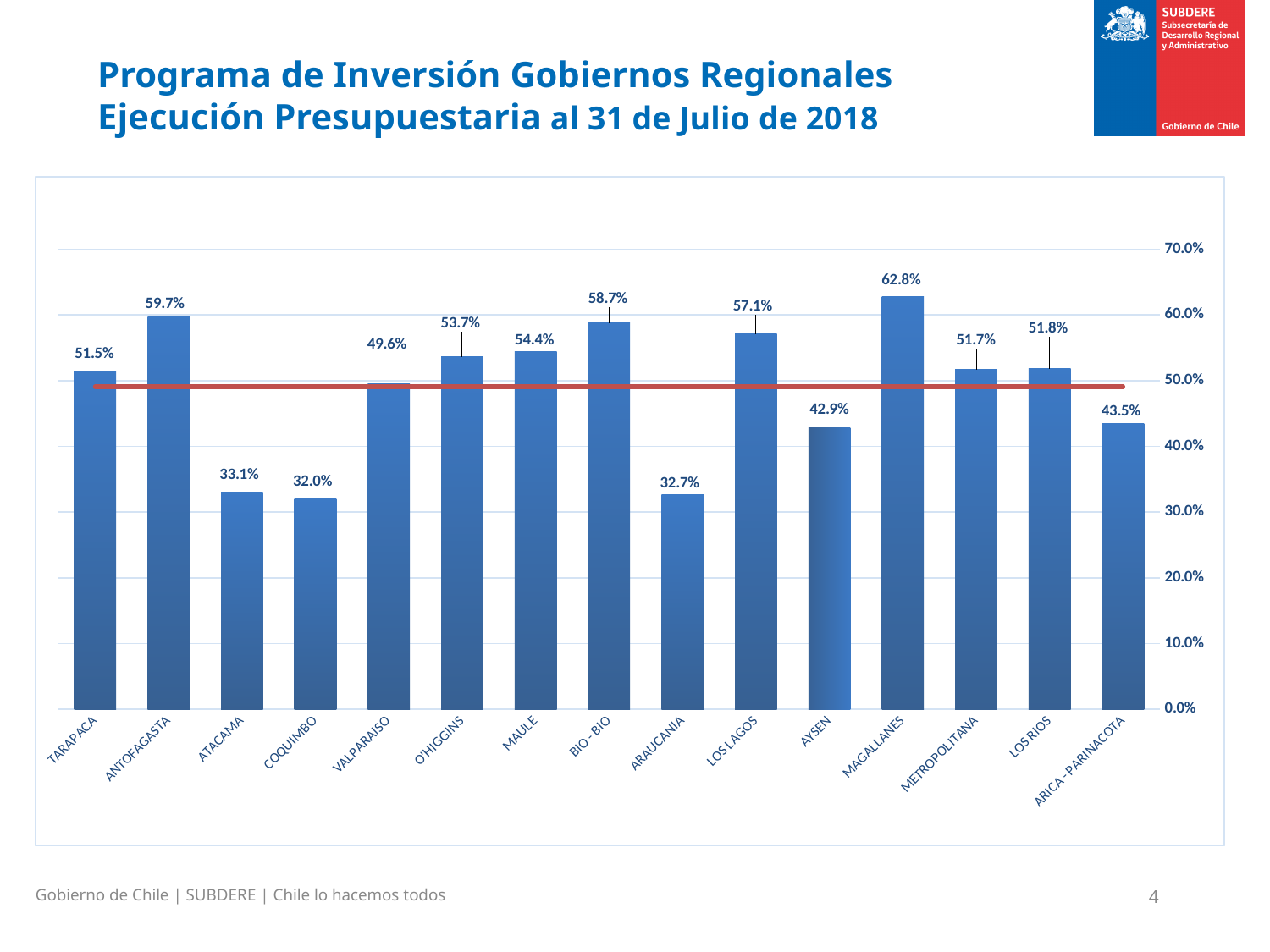
What is the value for MAGALLANES? 62.8% What is the value for ARAUCANIA? 32.7% Which region has the highest value? MAGALLANES Which is larger, the value for BIO - BIO or the value for LOS LAGOS? BIO - BIO What is the highest value shown on the y axis? 70.0% What is the difference between the values for MAGALLANES and ARICA - PARINACOTA? 19.3% What is the difference between the values for ANTOFAGASTA and ATACAMA? 26.6% What is the value for VALPARAISO? 49.6% Which region has the lowest value? COQUIMBO Is the value for AYSEN greater or less than 50.0%? less What kind of chart is shown on the slide? bar chart How many regions are shown on the x axis? 15